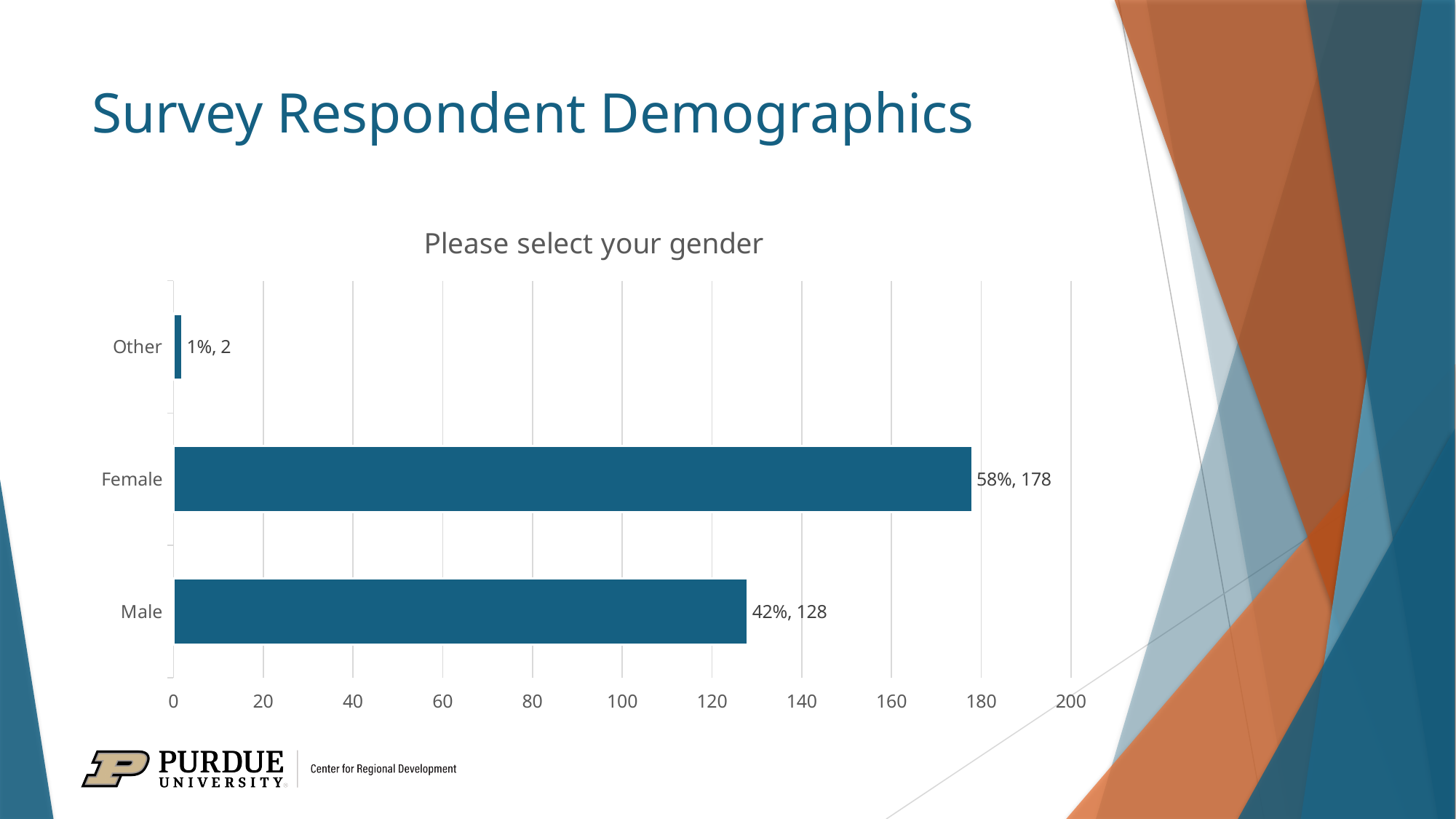
What kind of chart is shown on the slide? Bar chart Which gender category has the highest count? Female What percentage of respondents selected Male? 42% Which gender category has the lowest count? Other How many gender categories are shown in the chart? 3 How many respondents selected Other? 2 What is the difference in respondent count between Female and Male? 50 What is the total number of respondents across all three gender categories? 308 What is the title of the chart? Please select your gender Which has more respondents, Male or Female? Female Is the value for Male greater or less than 140? less How many respondents selected Female? 178